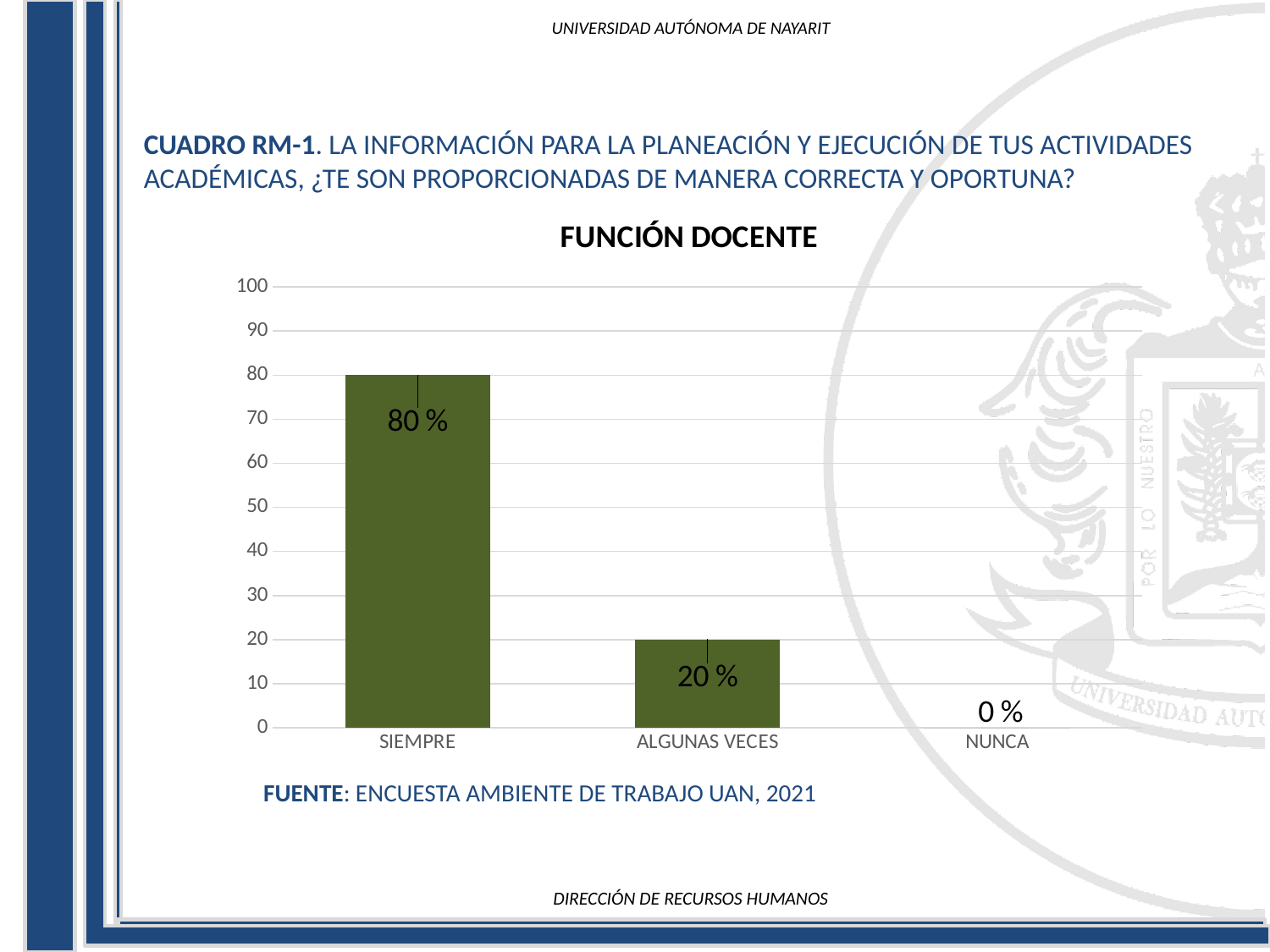
What is the difference between the values for SIEMPRE and ALGUNAS VECES? 60 % Which is larger, the value for ALGUNAS VECES or the value for NUNCA? ALGUNAS VECES Is the value for SIEMPRE greater or less than 50? greater How many categories are shown on the x axis? 3 Do the values rise or fall from left to right along the x axis? fall What kind of chart is shown? bar chart What is the value for SIEMPRE? 80 % What is the value for NUNCA? 0 % What is the title of the chart? FUNCIÓN DOCENTE What is the value for ALGUNAS VECES? 20 % Which category has the highest value? SIEMPRE Which category has the lowest value? NUNCA